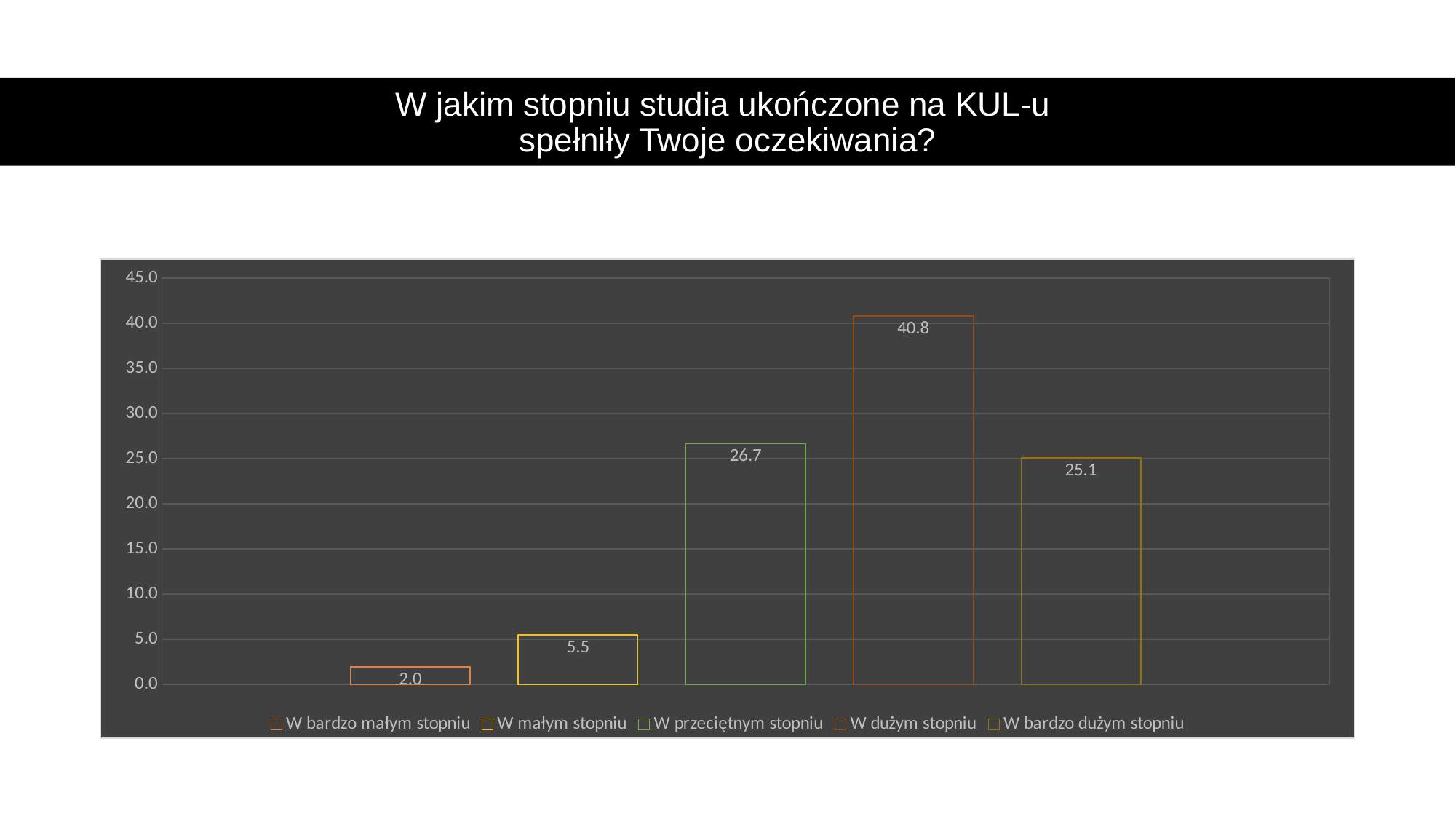
How many bars are plotted in the chart? 5 What is the value for "W dużym stopniu"? 40.8 What is the value for "W przeciętnym stopniu"? 26.7 Which is larger, the value for "W przeciętnym stopniu" or the value for "W bardzo dużym stopniu"? W przeciętnym stopniu How many entries does the legend list? 5 What is the value for "W bardzo małym stopniu"? 2.0 Which category has the highest value? W dużym stopniu What is the value for "W bardzo dużym stopniu"? 25.1 What is the difference between the values for "W dużym stopniu" and "W bardzo dużym stopniu"? 15.7 Is the value for "W małym stopniu" greater or less than 10.0? less Which category has the lowest value? W bardzo małym stopniu What kind of chart is shown on the slide? bar chart